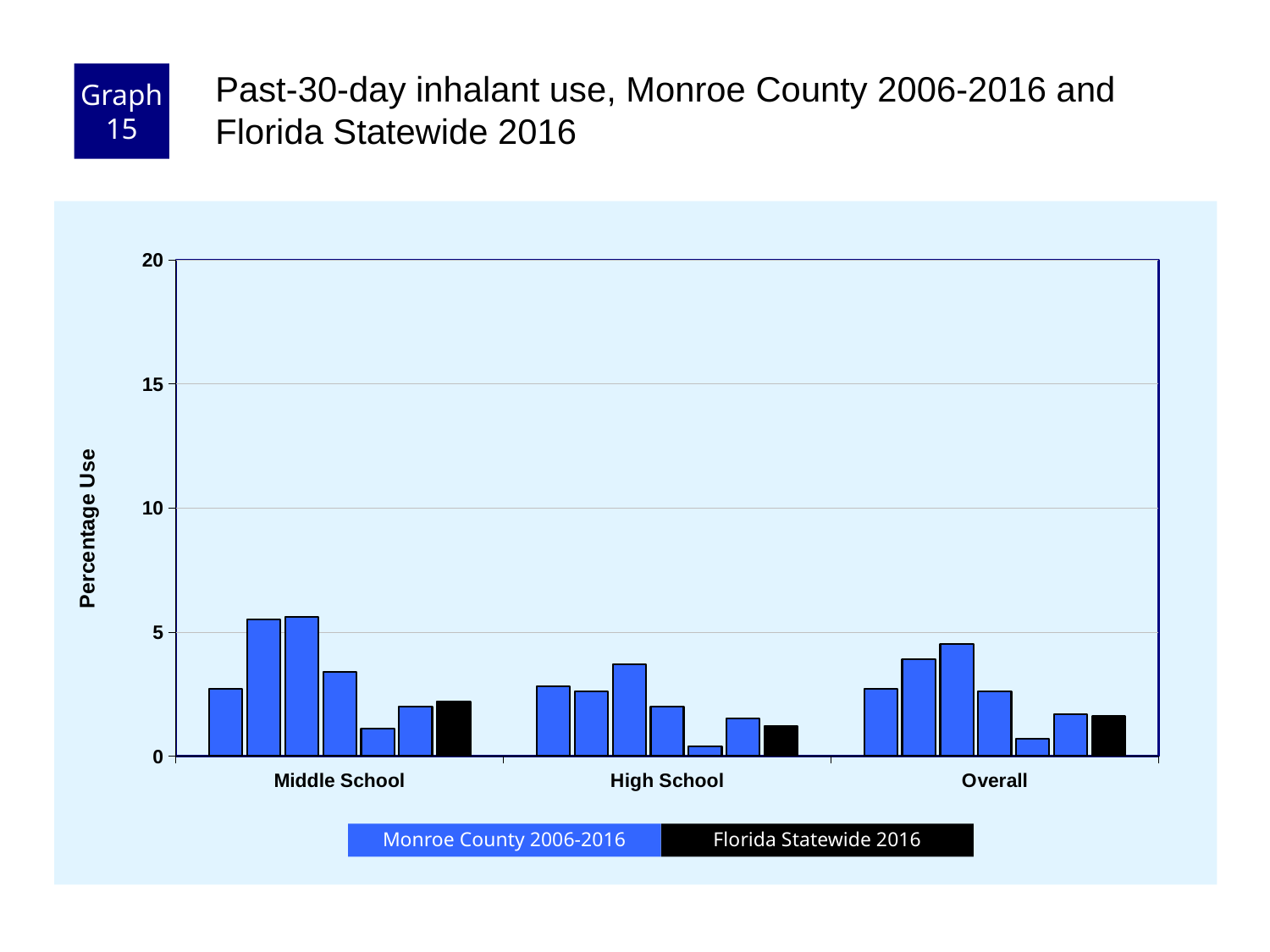
How many school-level categories are shown on the x axis? 3 How many series does the legend list? 2 Is the Florida Statewide 2016 value for Middle School greater or less than 5? less Is the Florida Statewide 2016 value for High School greater or less than 5? less What is the title of the y axis? Percentage Use Which is larger, the Florida Statewide 2016 value for Middle School or for High School? Middle School Which colour represents Florida Statewide 2016 in the legend? black What kind of chart is shown on the slide? bar chart Is the Florida Statewide 2016 value for Overall greater or less than 5? less Which category group contains the shortest bar on the chart? High School Which category group contains the tallest bar on the chart? Middle School